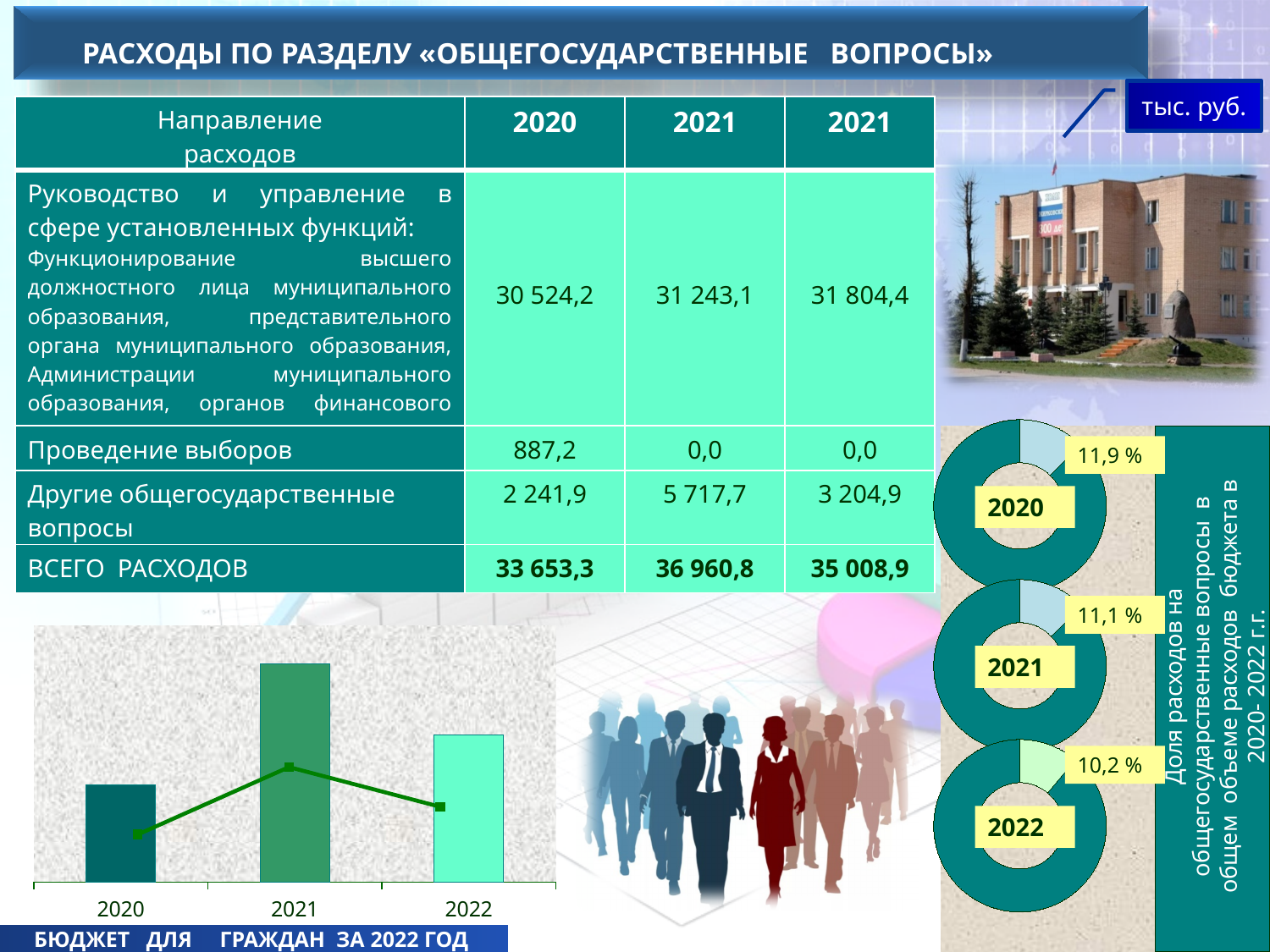
In the donut charts on the right, what is the difference between the share for 2020 and the share for 2022? 1,7 % In the donut charts on the right, what share is shown for 2022? 10,2 % Among the donut charts on the right, which year has the lowest share? 2022 In the bar chart at the bottom left, which year has the shortest bar? 2020 How many years are shown on the x axis of the bar chart at the bottom left? 3 Among the donut charts on the right, which year has the highest share? 2020 In the donut charts on the right, what share is shown for 2021? 11,1 % In the donut charts on the right, what share is shown for 2020? 11,9 % In the bar chart at the bottom left, is the bar for 2022 taller or shorter than the bar for 2020? taller What kind of chart is shown at the bottom left of the slide? bar chart In the bar chart at the bottom left, does the line rise or fall from 2021 to 2022? fall In the bar chart at the bottom left, which year has the tallest bar? 2021